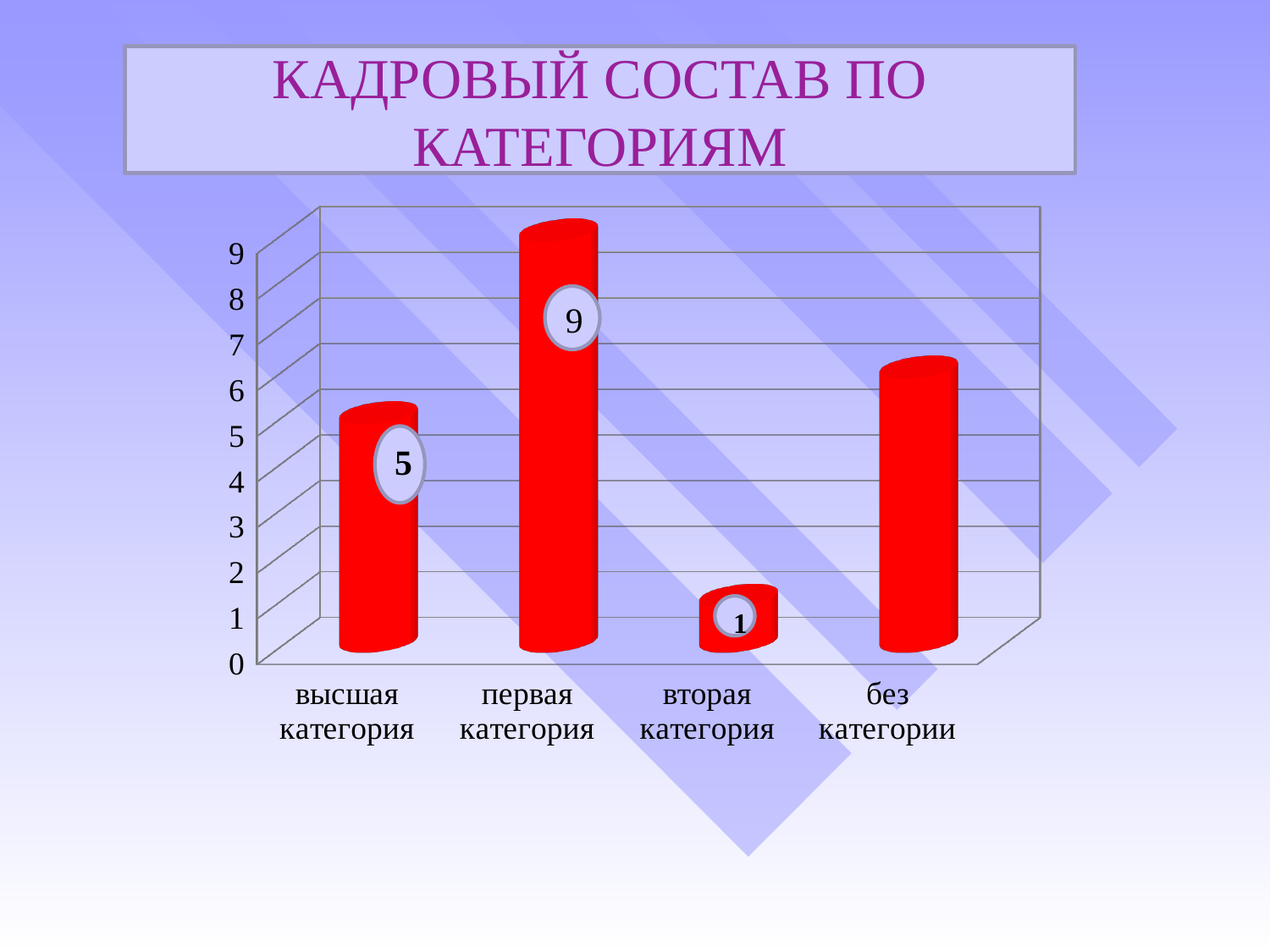
What is the value for высшая категория? 5 Which category has the lowest value? вторая категория What is the difference between the values for первая категория and высшая категория? 4 What is the value for первая категория? 9 What is the difference between the values for первая категория and вторая категория? 8 What is the value for вторая категория? 1 Which category has the highest value? первая категория What is the title of the slide? КАДРОВЫЙ СОСТАВ ПО КАТЕГОРИЯМ What kind of chart is shown on the slide? bar chart Which is larger, the value for высшая категория or the value for без категории? без категории Is the value for без категории greater or less than 5? greater How many categories are shown on the chart? 4